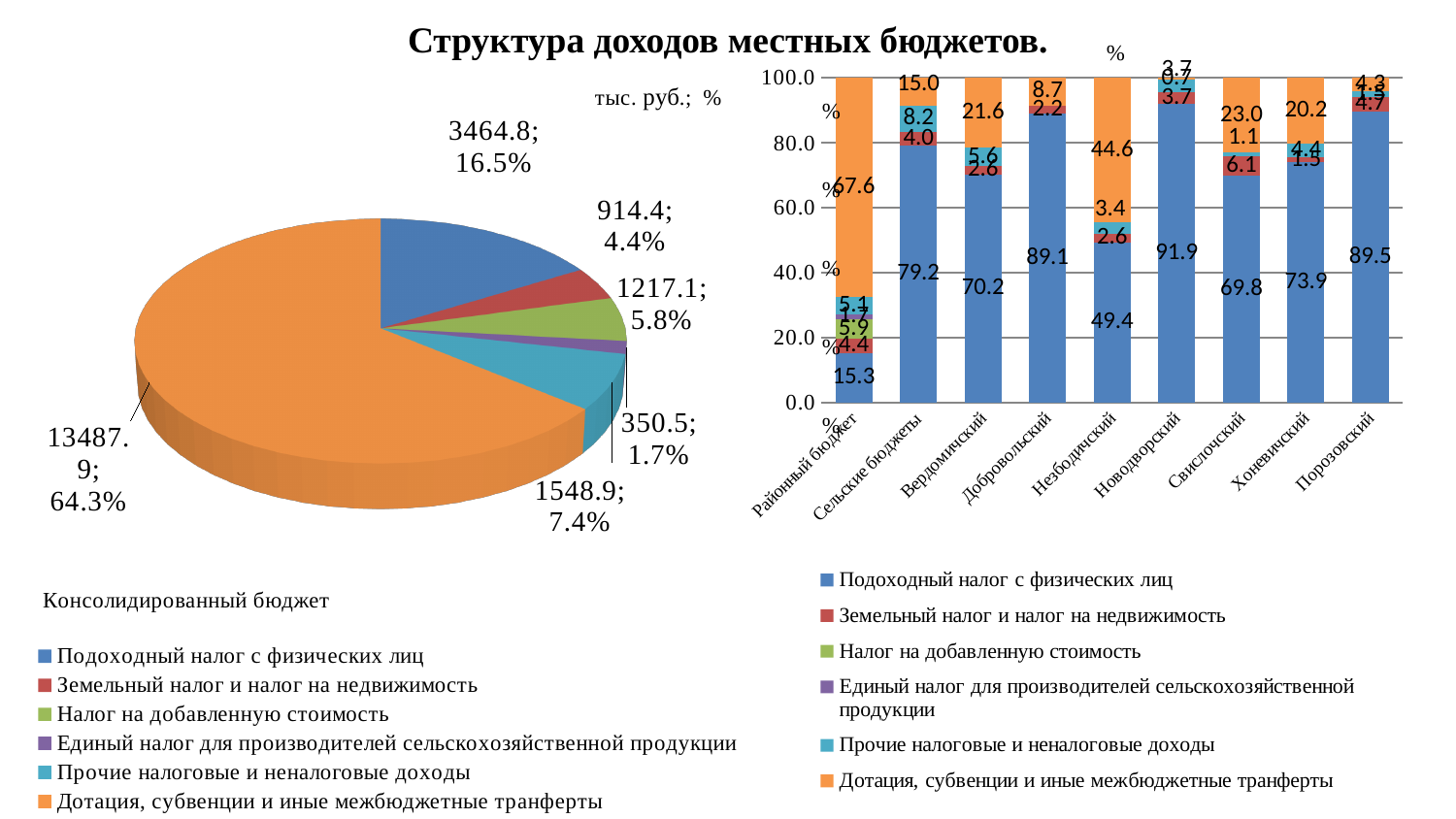
In the pie chart on the left, what value is shown for Дотация, субвенции и иные межбюджетные трансферты? 13487.9; 64.3% In the bar chart on the right, what is the difference between the Подоходный налог с физических лиц values for Порозовский and Свислочский? 19.7 How many series does the legend of the bar chart on the right list? 6 How many categories are shown on the x axis of the bar chart on the right? 9 In the bar chart on the right, what is the value of Дотация, субвенции и иные межбюджетные трансферты for Незбодичский? 44.6 In the pie chart on the left, which is larger: Налог на добавленную стоимость or Земельный налог и налог на недвижимость? Налог на добавленную стоимость What kind of chart is the chart on the left of the slide? pie chart What kind of chart is the chart on the right of the slide? bar chart In the bar chart on the right, which category has the lowest value for Подоходный налог с физических лиц? Районный бюджет In the bar chart on the right, what is the value of Подоходный налог с физических лиц for Новодворский? 91.9 In the pie chart on the left, what share of the pie does Подоходный налог с физических лиц have? 16.5% In the pie chart on the left, which category has the smallest slice? Единый налог для производителей сельскохозяйственной продукции